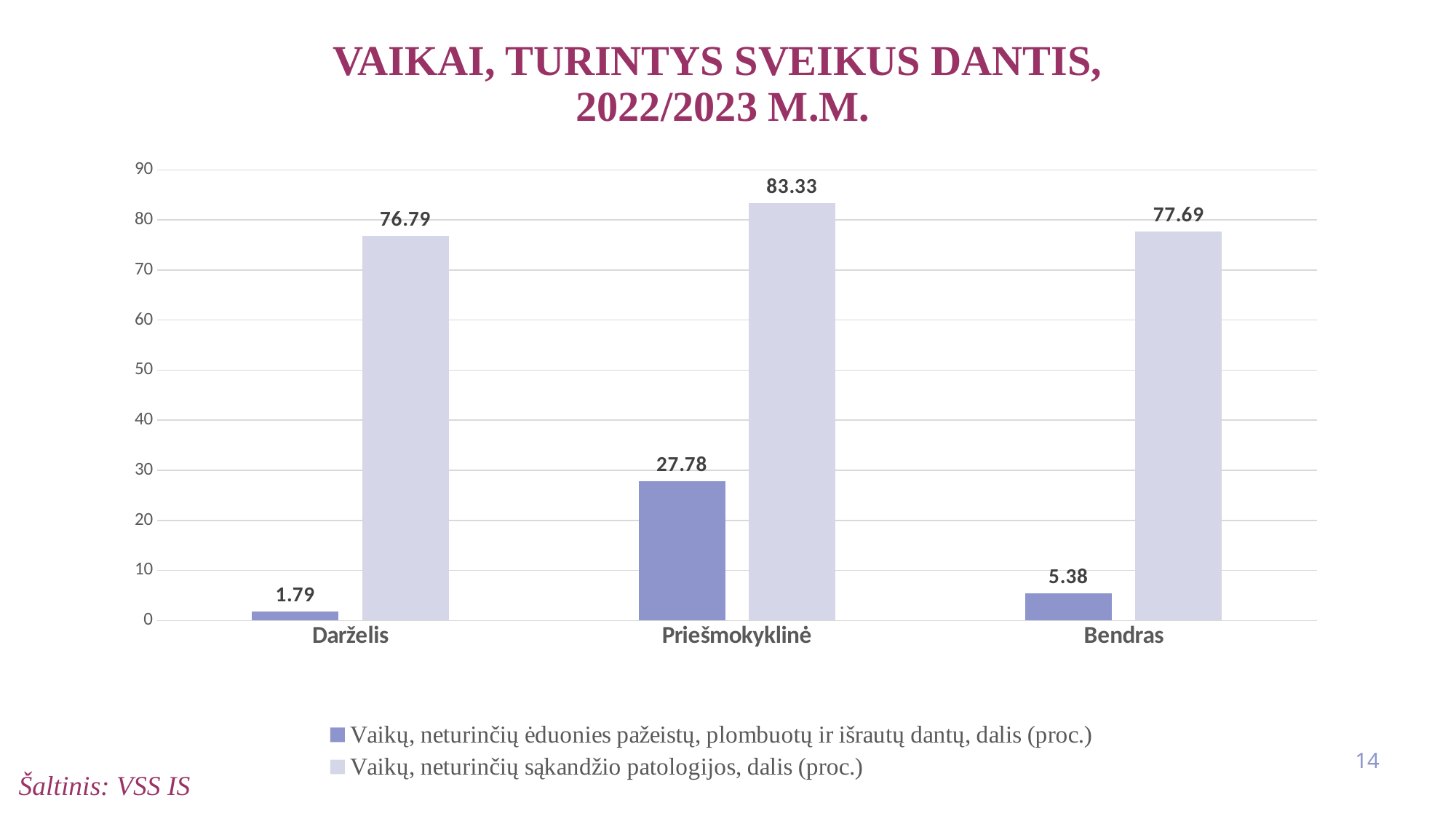
Which is larger: the 'Vaikų, neturinčių sąkandžio patologijos' value for Darželis or for Bendras? Bendras Which category has the highest value in the series 'Vaikų, neturinčių sąkandžio patologijos, dalis (proc.)'? Priešmokyklinė Is the value for Priešmokyklinė in the series 'Vaikų, neturinčių ėduonies pažeistų, plombuotų ir išrautų dantų, dalis (proc.)' greater or less than 30? less How many categories are shown on the x axis? 3 What is the title of the chart? VAIKAI, TURINTYS SVEIKUS DANTIS, 2022/2023 M.M. What is the difference between the two series values for Priešmokyklinė? 55.55 What is the value for Priešmokyklinė in the series 'Vaikų, neturinčių sąkandžio patologijos, dalis (proc.)'? 83.33 How many series does the legend list? 2 What is the value for Darželis in the series 'Vaikų, neturinčių ėduonies pažeistų, plombuotų ir išrautų dantų, dalis (proc.)'? 1.79 Which category has the lowest value in the series 'Vaikų, neturinčių ėduonies pažeistų, plombuotų ir išrautų dantų, dalis (proc.)'? Darželis What kind of chart is shown on the slide? bar chart What is the value for Bendras in the series 'Vaikų, neturinčių ėduonies pažeistų, plombuotų ir išrautų dantų, dalis (proc.)'? 5.38